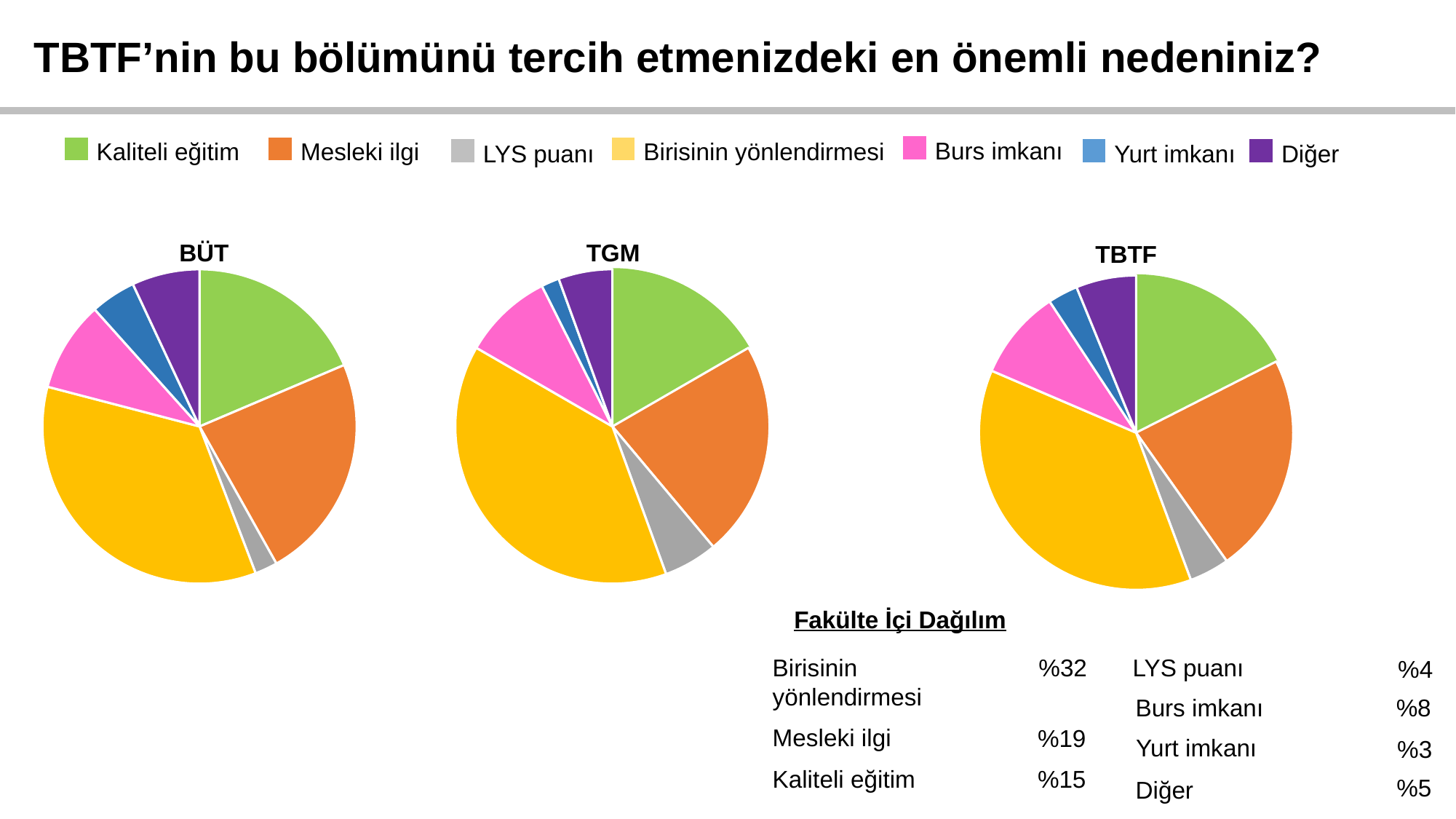
Which colour represents Burs imkanı in the legend? Pink In the TGM pie chart, which category has the largest slice? Birisinin yönlendirmesi What is the title of the pie chart on the right? TBTF In the BÜT pie chart, which slice is larger: Mesleki ilgi or Kaliteli eğitim? Mesleki ilgi What kind of charts are shown on the slide? Pie charts In the TGM pie chart, which category has the smallest slice? Yurt imkanı In the BÜT pie chart, which category has the smallest slice? LYS puanı How many categories does the legend list? 7 In the BÜT pie chart, which category has the largest slice? Birisinin yönlendirmesi How many pie charts are on the slide? 3 In the TBTF pie chart, which category has the largest slice? Birisinin yönlendirmesi In the TGM pie chart, which slice is larger: Mesleki ilgi or Burs imkanı? Mesleki ilgi